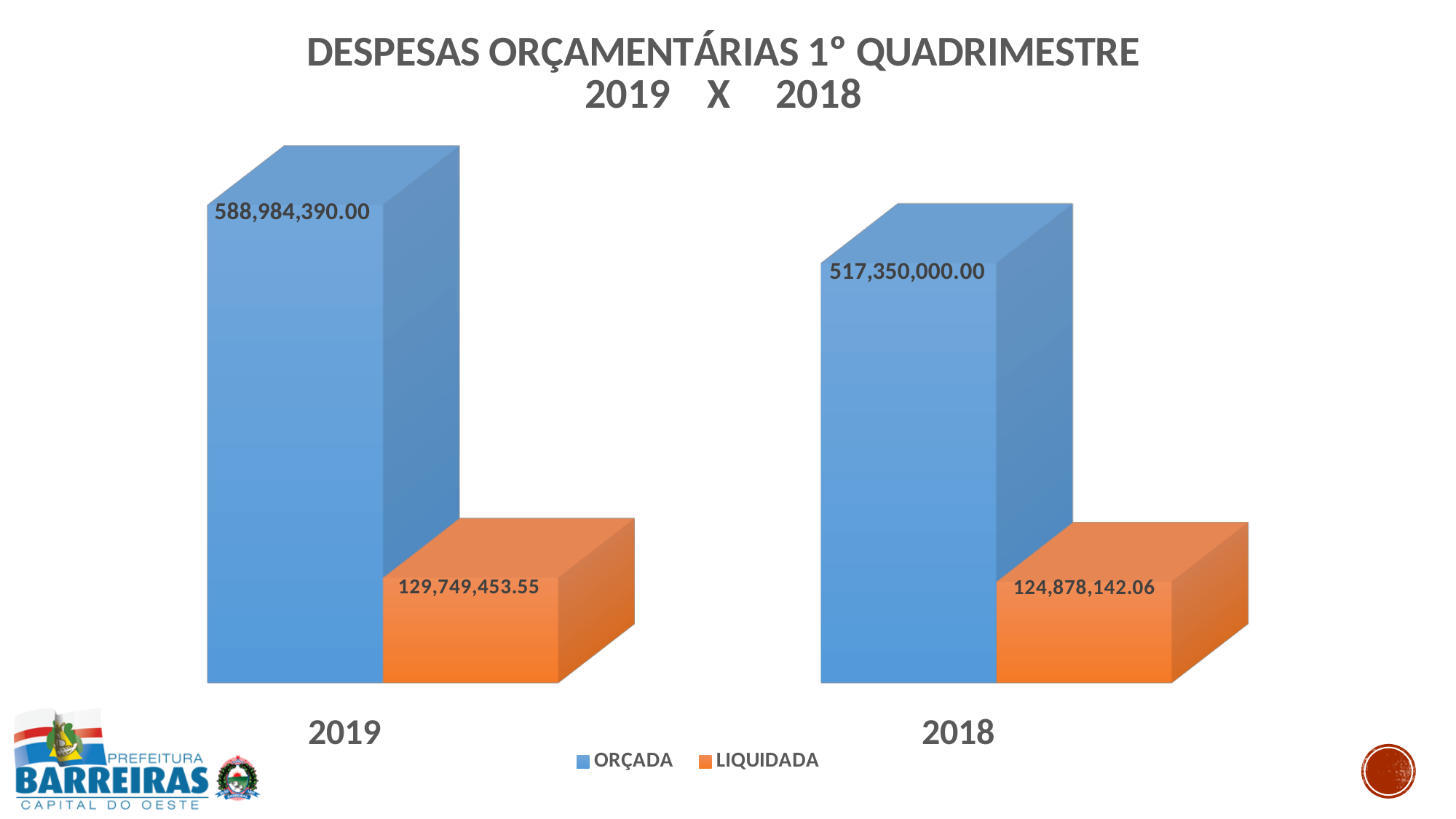
What is the ORÇADA value for 2019? 588,984,390.00 Which bar shows the lowest value on the chart? LIQUIDADA 2018 Which year has the higher ORÇADA value? 2019 What is the difference between ORÇADA and LIQUIDADA for 2019? 459,234,936.45 What is the ORÇADA value for 2018? 517,350,000.00 What type of chart is shown on the slide? bar chart Is the LIQUIDADA value for 2019 larger or smaller than the LIQUIDADA value for 2018? larger What is the difference between the ORÇADA values for 2019 and 2018? 71,634,390.00 What is the LIQUIDADA value for 2019? 129,749,453.55 How many years (categories) are shown on the chart? 2 What is the LIQUIDADA value for 2018? 124,878,142.06 How many series does the legend list? 2